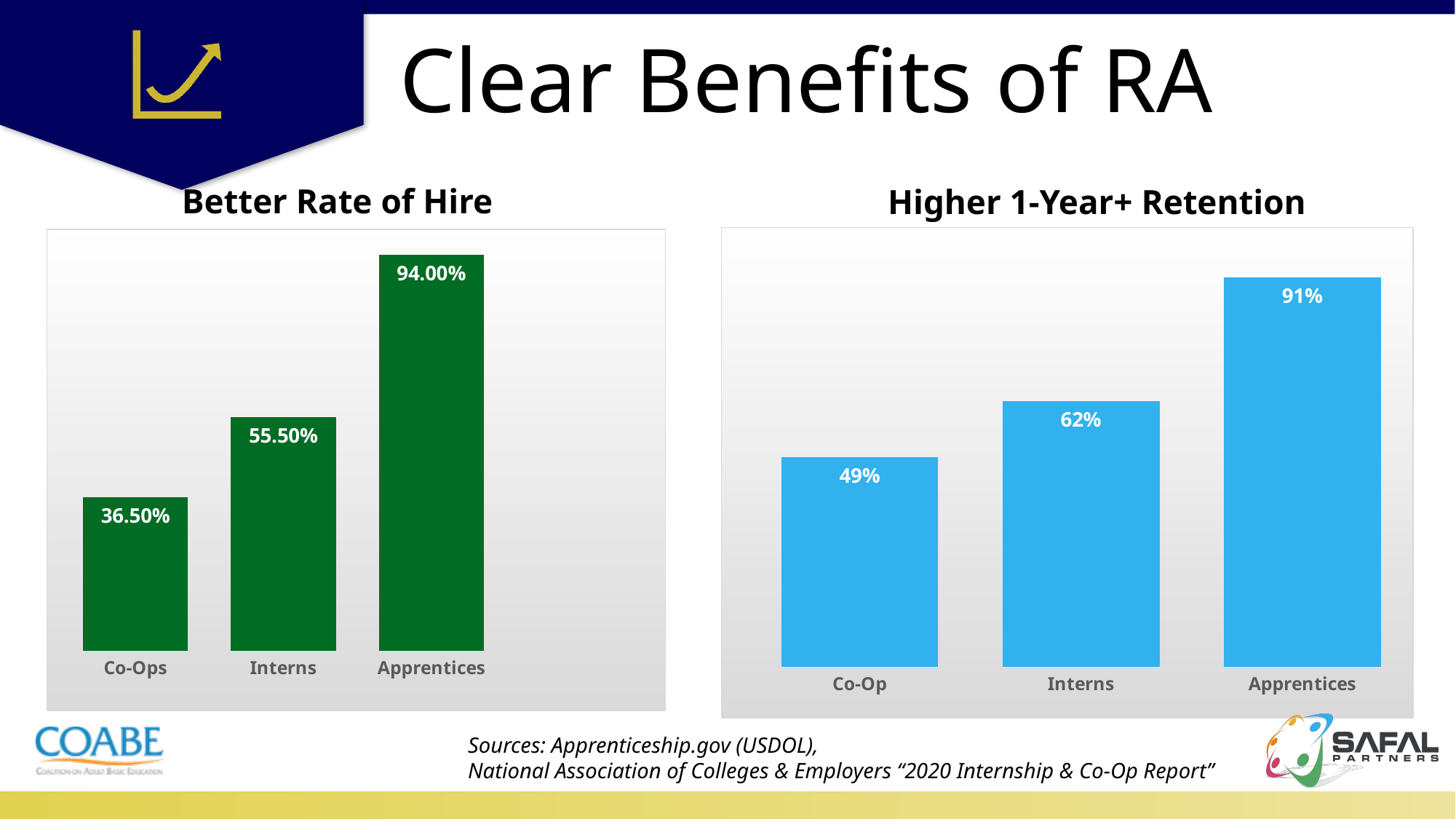
In the 'Better Rate of Hire' chart, which category has the highest value? Apprentices What colour are the bars in the 'Higher 1-Year+ Retention' chart? Blue In the 'Better Rate of Hire' chart, what is the value for Co-Ops? 36.50% How many categories are shown in the 'Better Rate of Hire' chart? 3 In the 'Higher 1-Year+ Retention' chart, which category has the lowest value? Co-Op In the 'Higher 1-Year+ Retention' chart, what is the difference between the values for Apprentices and Co-Op? 42% In the 'Better Rate of Hire' chart, what is the value for Apprentices? 94.00% In the 'Better Rate of Hire' chart, what is the difference between the values for Apprentices and Interns? 38.50% In the 'Better Rate of Hire' chart, do the values rise or fall from Co-Ops to Apprentices? Rise In the 'Higher 1-Year+ Retention' chart, which is larger, the value for Interns or the value for Co-Op? Interns In the 'Higher 1-Year+ Retention' chart, what is the value for Interns? 62% What kind of chart is the 'Higher 1-Year+ Retention' chart? Bar chart